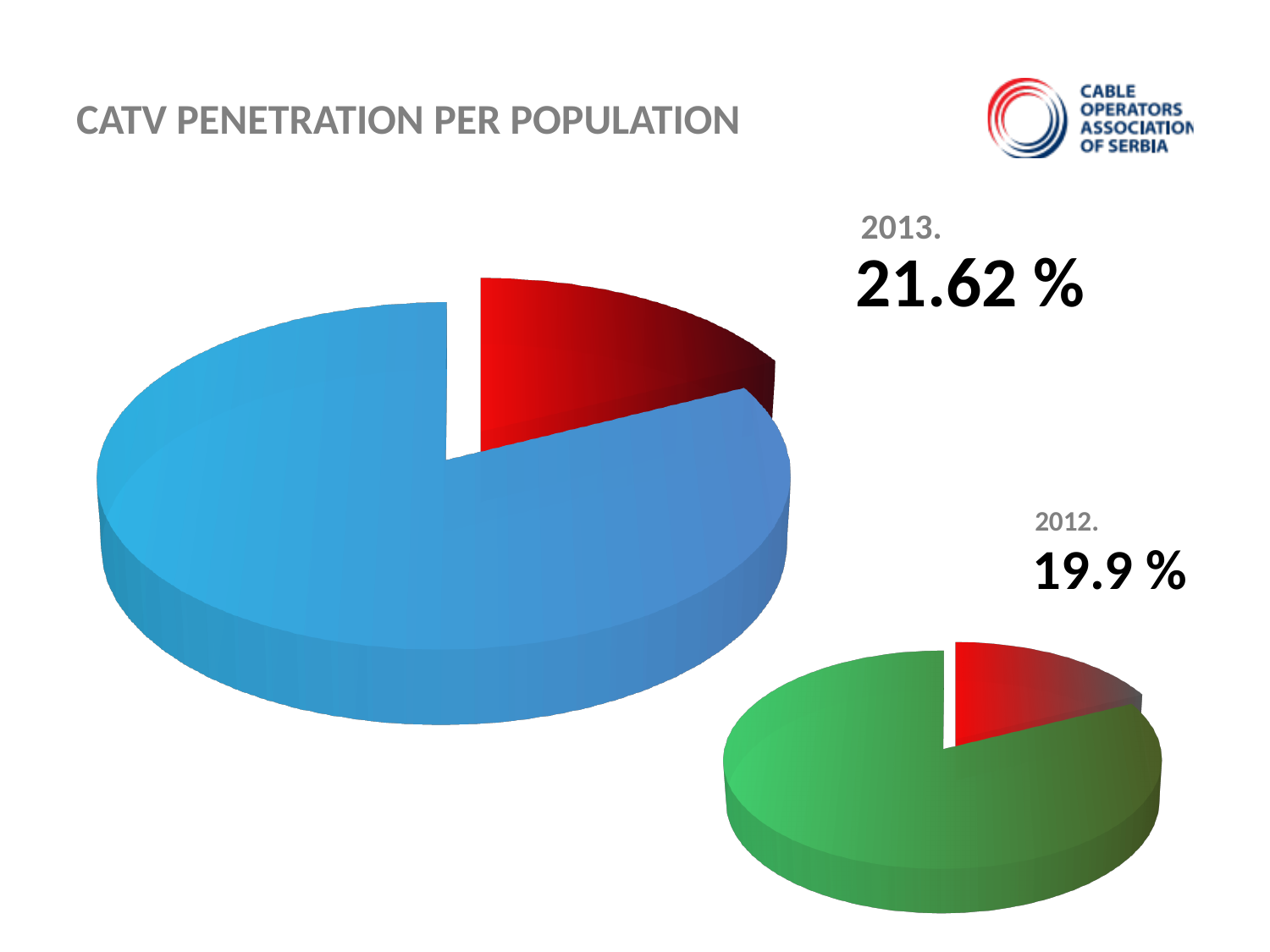
By how many percentage points did CATV penetration per population increase from 2012 to 2013? 1.72 What is the CATV penetration per population shown for 2013? 21.62 % What kind of chart is used to show the CATV penetration for each year? pie chart How many slices does the 2013 pie chart have? 2 What is the title of the slide containing the pie charts? CATV PENETRATION PER POPULATION What colour is the larger slice of the 2012 pie chart? green What is the CATV penetration per population shown for 2012? 19.9 % In the 2012 pie chart, what share of the pie does the red slice represent? 19.9 % Which year shows the higher CATV penetration per population, 2012 or 2013? 2013 How many pie charts are shown on the slide? 2 In the 2013 pie chart, what share of the pie does the red slice represent? 21.62 % Did CATV penetration per population rise or fall from 2012 to 2013? rise